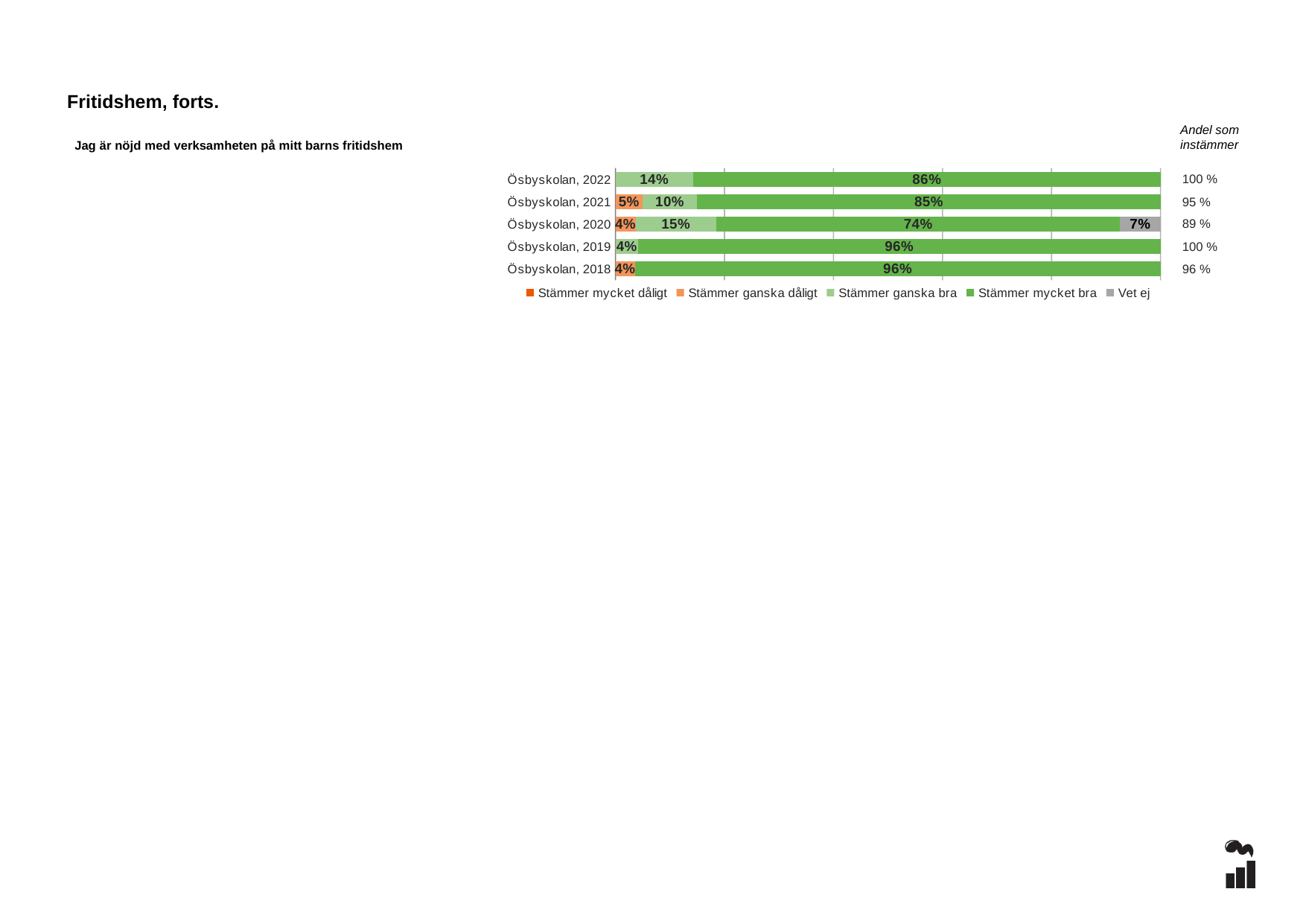
How many series does the legend list? 5 What is the "Andel som instämmer" value shown for Ösbyskolan, 2020? 89 % What is the value for "Stämmer ganska bra" for Ösbyskolan, 2020? 15% What is the value for "Stämmer ganska dåligt" for Ösbyskolan, 2021? 5% How many categories (bars) are shown in the chart? 5 What is the difference between the "Stämmer mycket bra" values for Ösbyskolan, 2019 and Ösbyskolan, 2020? 22% What kind of chart is shown on the slide? stacked bar chart Which category has the lowest value for "Stämmer mycket bra"? Ösbyskolan, 2020 What is the value for "Vet ej" for Ösbyskolan, 2020? 7% Which legend entry is shown in grey? Vet ej Which is larger: the "Stämmer ganska bra" value for Ösbyskolan, 2022 or for Ösbyskolan, 2021? Ösbyskolan, 2022 What is the value for "Stämmer mycket bra" for Ösbyskolan, 2022? 86%